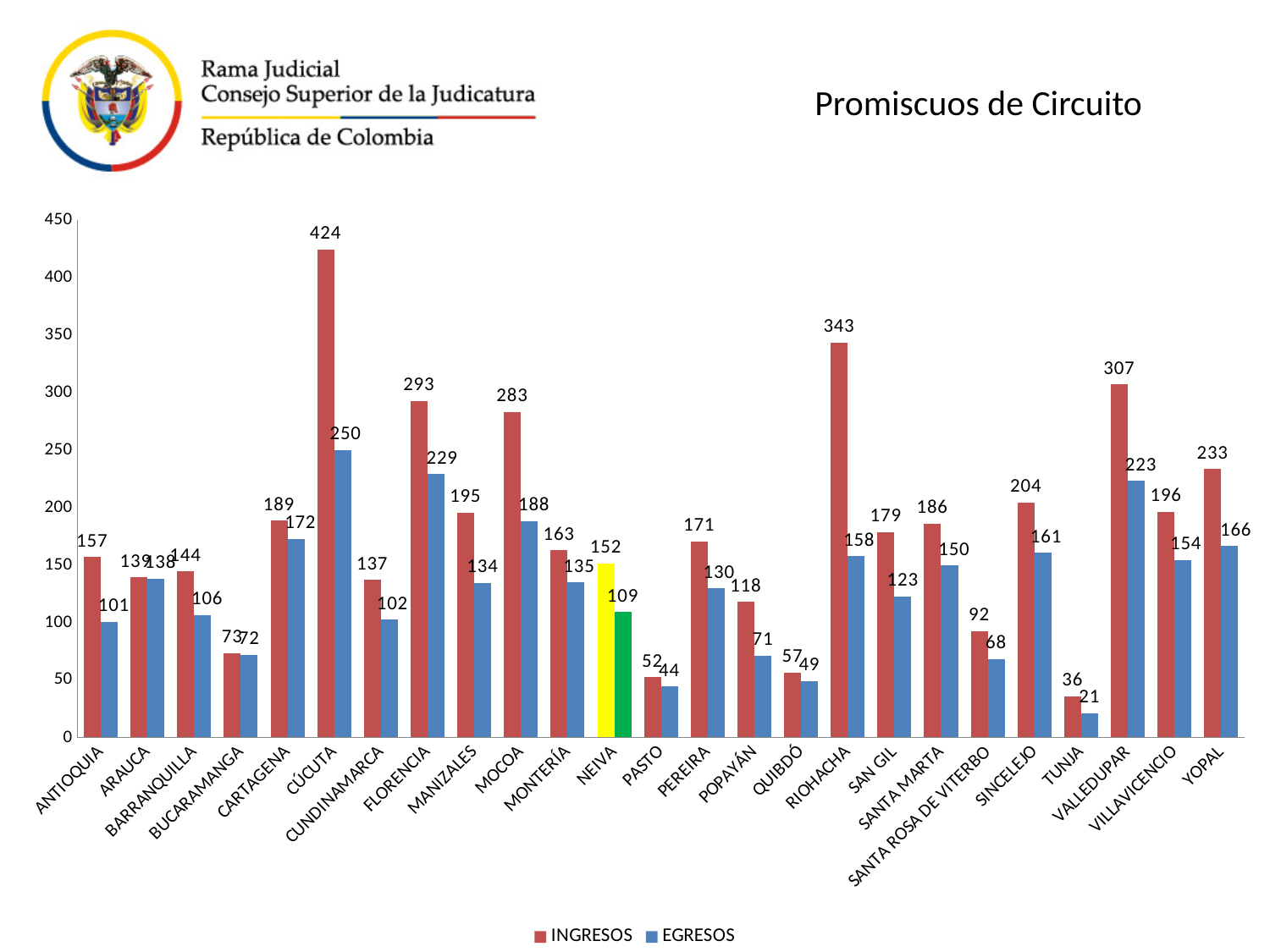
How many series does the legend list? 2 What is the title of the chart? Promiscuos de Circuito What is the EGRESOS value for SANTA ROSA DE VITERBO? 68 How many categories are shown on the x axis? 25 What is the INGRESOS value for NEIVA? 152 What kind of chart is shown on the slide? Bar chart Which category has the lowest EGRESOS value? TUNJA What is the INGRESOS value for CÚCUTA? 424 What is the EGRESOS value for RIOHACHA? 158 What is the difference between INGRESOS and EGRESOS for RIOHACHA? 185 Which is larger, the INGRESOS value for VALLEDUPAR or the INGRESOS value for FLORENCIA? VALLEDUPAR Which category has the highest INGRESOS value? CÚCUTA